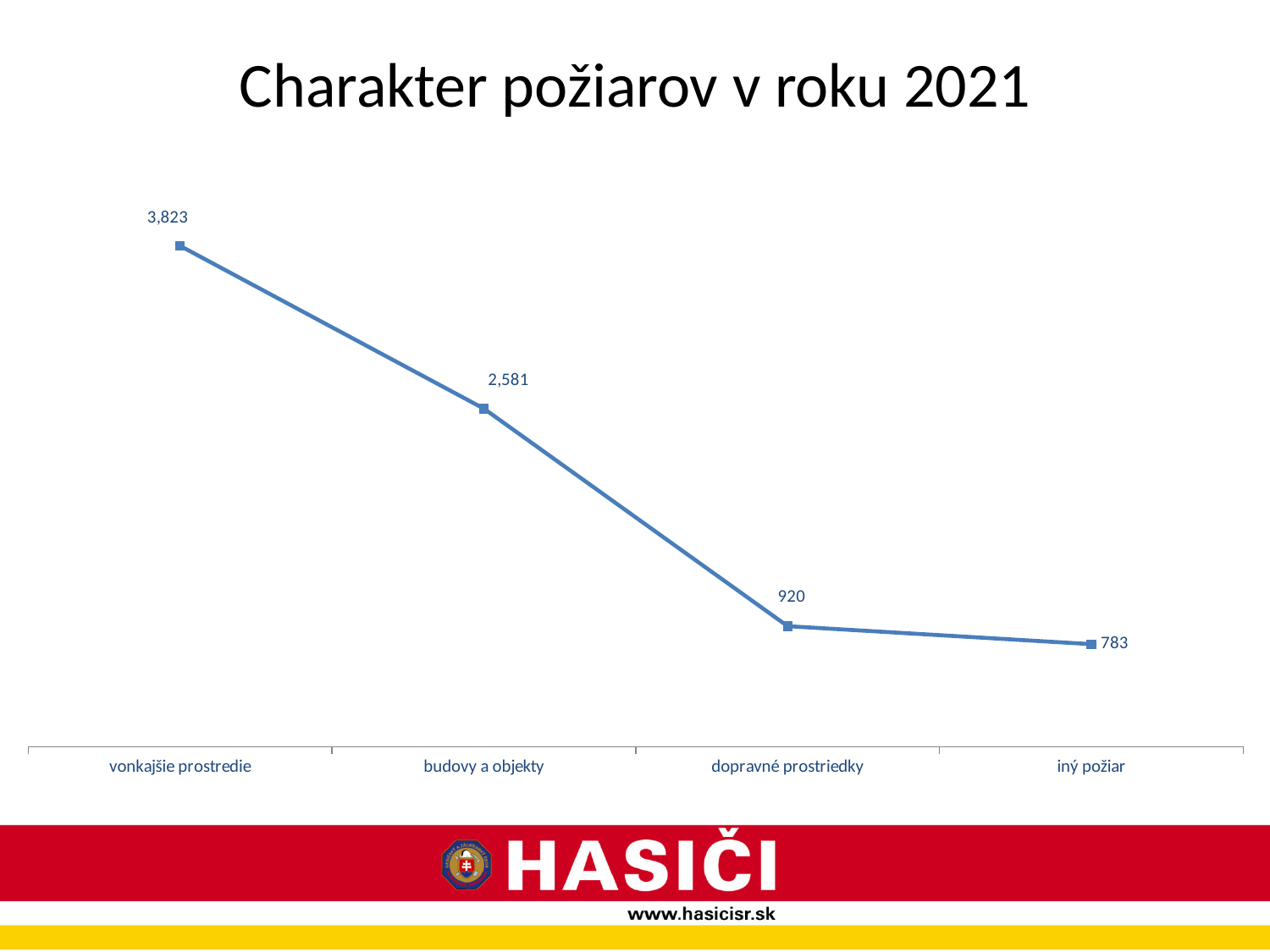
How many categories are plotted on the chart? 4 What is the difference between the values for vonkajšie prostredie and budovy a objekty? 1,242 What is the value for iný požiar? 783 What kind of chart is shown on the slide? line chart What is the difference between the values for dopravné prostriedky and iný požiar? 137 What is the value for dopravné prostriedky? 920 What is the value for budovy a objekty? 2,581 Which category has the lowest value? iný požiar What is the value for vonkajšie prostredie? 3,823 Do the values rise or fall from left to right along the x axis? fall Which category has the highest value? vonkajšie prostredie Which is larger, the value for budovy a objekty or the value for dopravné prostriedky? budovy a objekty